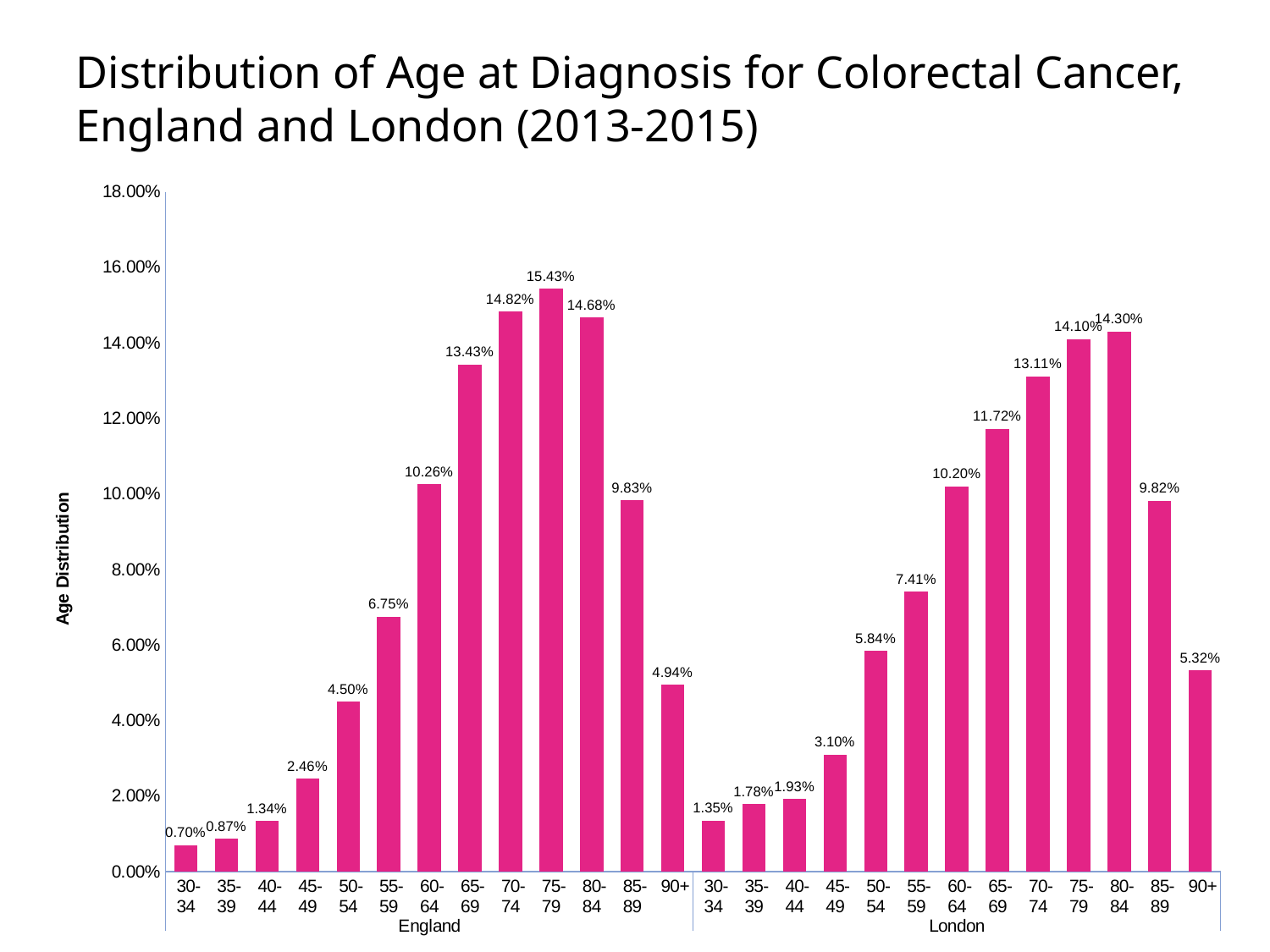
Which is larger, the 85-89 value for England or the 85-89 value for London? England What is the value for the 60-64 age group in London? 10.20% What kind of chart is shown on the slide? Bar chart Which age group has the highest value in England? 75-79 What is the value for the 75-79 age group in England? 15.43% Which age group has the lowest value in London? 30-34 How many age groups are shown for England? 13 Is the value for the 65-69 age group in London greater or less than 12.00%? less What is the label on the vertical axis? Age Distribution Which age group has the highest value in London? 80-84 What is the difference between the 75-79 value for England and the 75-79 value for London? 1.33% What is the value for the 90+ age group in London? 5.32%